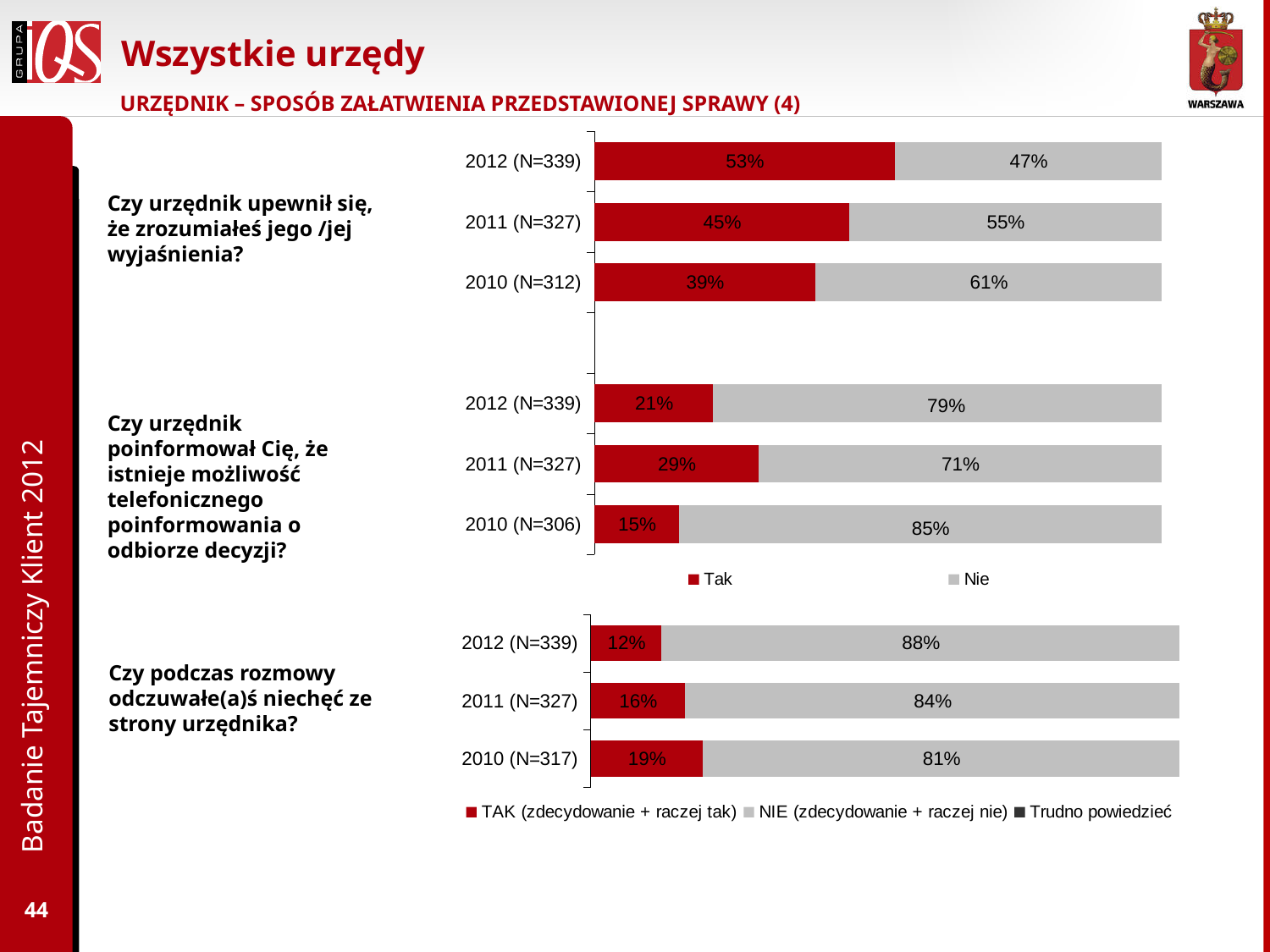
In the middle chart ("Czy urzędnik poinformował Cię, że istnieje możliwość telefonicznego poinformowania o odbiorze decyzji?"), what is the Tak value for 2011 (N=327)? 29% How many series does the legend of the bottom chart ("Czy podczas rozmowy odczuwałe(a)ś niechęć ze strony urzędnika?") list? 3 In the top chart ("Czy urzędnik upewnił się, że zrozumiałeś jego/jej wyjaśnienia?"), what is the difference between the Tak values for 2012 and 2010? 14 percentage points In the middle chart ("Czy urzędnik poinformował Cię, że istnieje możliwość telefonicznego poinformowania o odbiorze decyzji?"), what is the total of the 2012 (N=339) bar? 100% In the top chart ("Czy urzędnik upewnił się, że zrozumiałeś jego/jej wyjaśnienia?"), does the Tak value rise or fall from 2010 to 2012? rise In the top chart ("Czy urzędnik upewnił się, że zrozumiałeś jego/jej wyjaśnienia?"), which year has the highest Tak value? 2012 (N=339) In the top chart ("Czy urzędnik upewnił się, że zrozumiałeś jego/jej wyjaśnienia?"), what is the Tak value for 2012 (N=339)? 53% What kind of chart is the top chart ("Czy urzędnik upewnił się, że zrozumiałeś jego/jej wyjaśnienia?")? stacked bar chart In the middle chart ("Czy urzędnik poinformował Cię, że istnieje możliwość telefonicznego poinformowania o odbiorze decyzji?"), which year has the lowest Tak value? 2010 (N=306) In the bottom chart ("Czy podczas rozmowy odczuwałe(a)ś niechęć ze strony urzędnika?"), which is larger: the TAK value for 2010 (N=317) or for 2011 (N=327)? 2010 (N=317) In the top chart ("Czy urzędnik upewnił się, że zrozumiałeś jego/jej wyjaśnienia?"), what is the Nie value for 2010 (N=312)? 61% In the bottom chart ("Czy podczas rozmowy odczuwałe(a)ś niechęć ze strony urzędnika?"), what is the NIE value for 2012 (N=339)? 88%